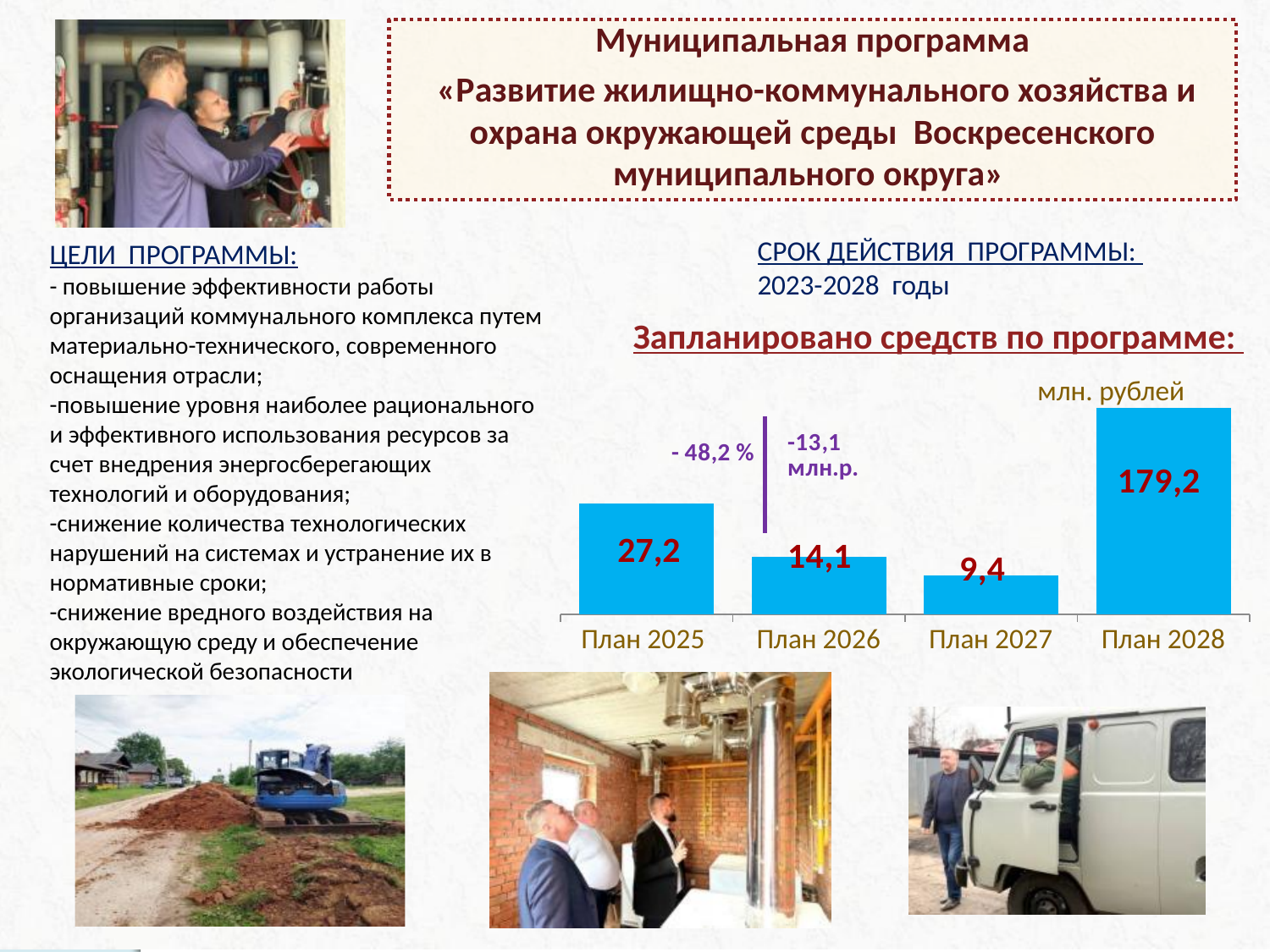
In what units are the values on the chart given? млн. рублей Which year has the lowest planned amount on the chart? План 2027 What is the planned amount for План 2028 on the chart? 179,2 How many categories (years) are shown on the chart? 4 What is the planned amount for План 2026 on the chart? 14,1 What type of chart is used to show the planned funds? Bar chart What is the planned amount for План 2027 on the chart? 9,4 What is the difference between the planned amounts for План 2025 and План 2026? 13,1 Which year has the highest planned amount on the chart? План 2028 What is the planned amount for План 2025 on the chart? 27,2 Which is larger: the planned amount for План 2026 or for План 2027? План 2026 What is the difference between the planned amounts for План 2028 and План 2027? 169,8